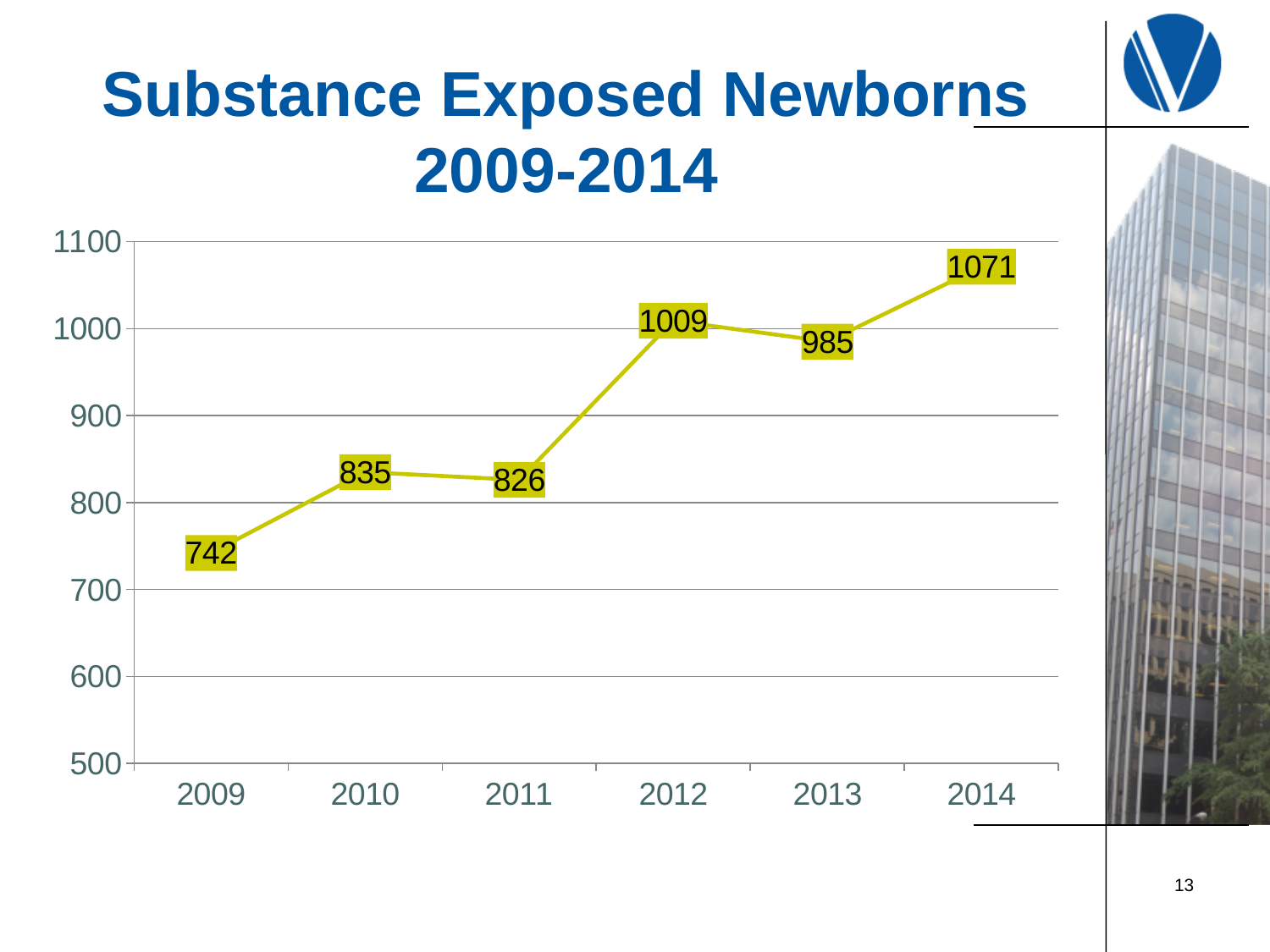
What is the value for 2009? 742 What kind of chart is shown on the slide? line chart What is the value for 2012? 1009 Which is larger, the value for 2010 or the value for 2011? 2010 What is the difference between the values for 2014 and 2009? 329 What is the difference between the values for 2012 and 2013? 24 What is the title of the chart? Substance Exposed Newborns 2009-2014 How many years are plotted on the chart? 6 Is the value for 2013 greater or less than 1000? less Which year has the highest value? 2014 Which year has the lowest value? 2009 What is the value for 2014? 1071